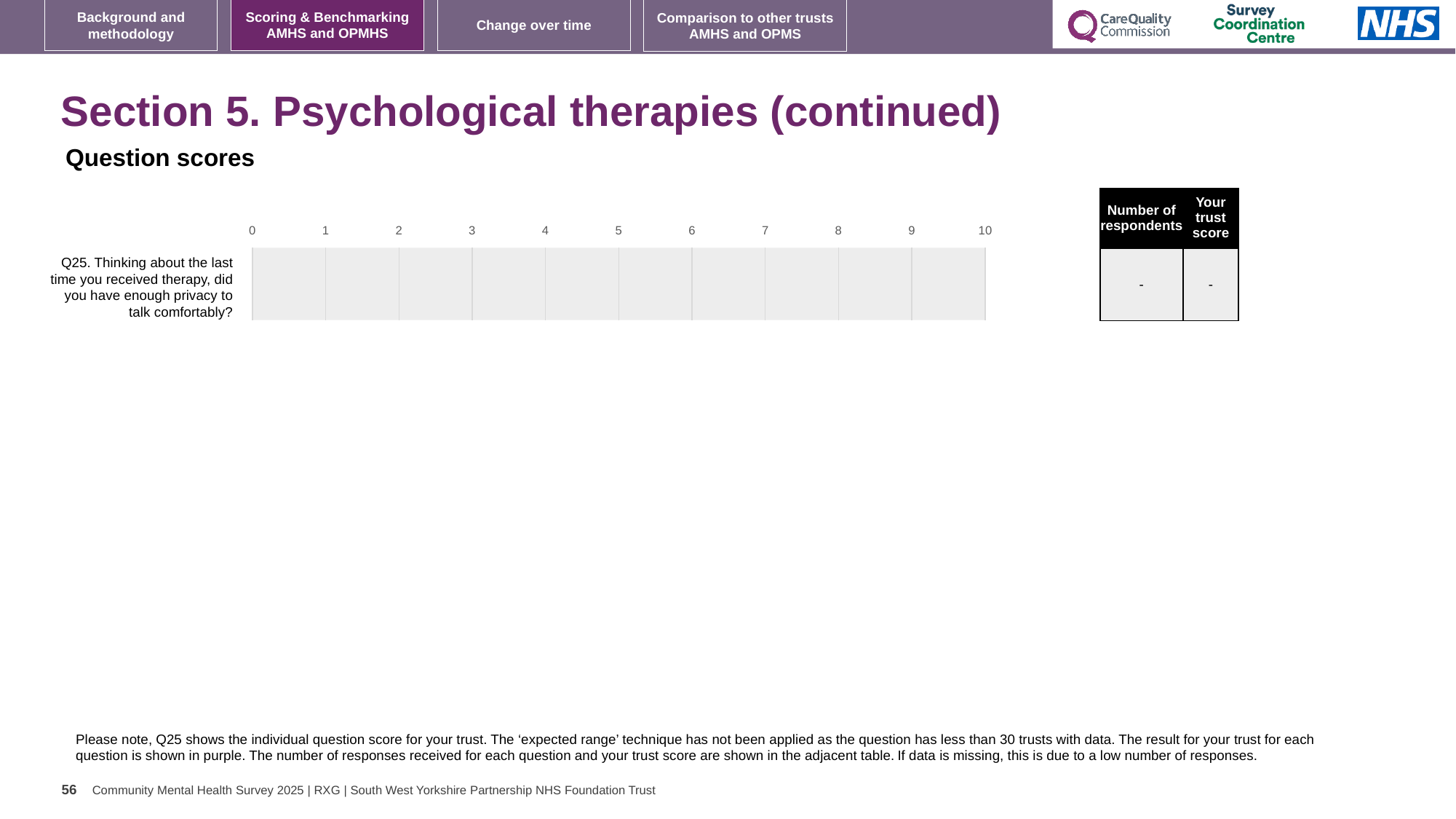
Is a bar plotted for Q25 on the chart? No How many questions (categories) are shown on the chart? 1 What is the lowest value shown on the chart's x axis? 0 What is the highest value shown on the chart's x axis? 10 What is shown in the 'Your trust score' column of the table for Q25? - What kind of chart is shown on the slide? Bar chart Which question number is shown on the chart? Q25 What is shown in the 'Number of respondents' column of the table for Q25? -